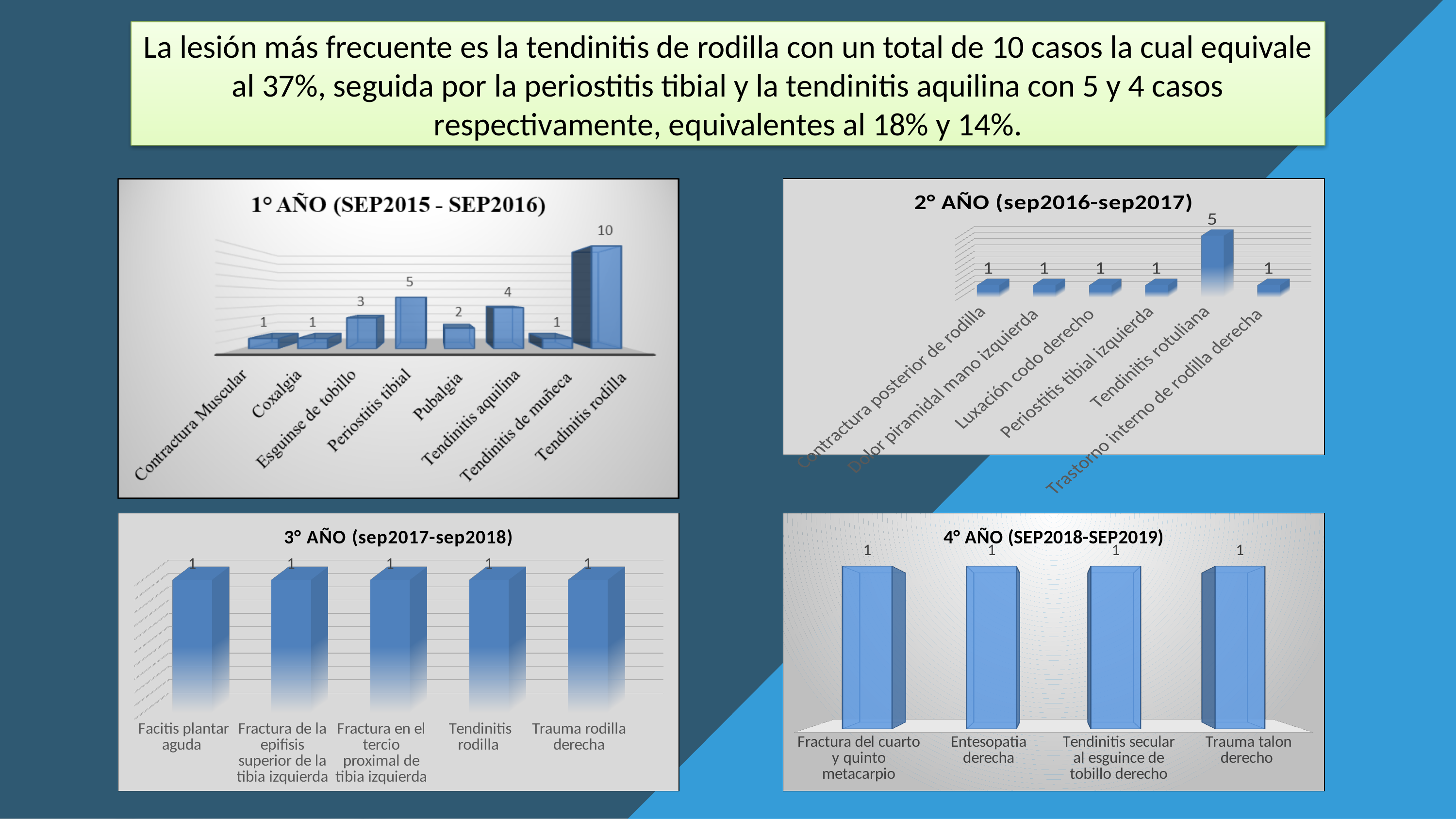
In the chart titled "1° AÑO (SEP2015 - SEP2016)", what is the value for Tendinitis rodilla? 10 In the chart titled "2° AÑO (sep2016-sep2017)", what is the value for Tendinitis rotuliana? 5 How many categories are shown in the chart titled "1° AÑO (SEP2015 - SEP2016)"? 8 In the chart titled "1° AÑO (SEP2015 - SEP2016)", what is the value for Periostitis tibial? 5 In the chart titled "4° AÑO (SEP2018-SEP2019)", what is the value for Trauma talon derecho? 1 In the chart titled "1° AÑO (SEP2015 - SEP2016)", which is larger, Esguinse de tobillo or Pubalgia? Esguinse de tobillo What kind of chart is the chart titled "4° AÑO (SEP2018-SEP2019)"? Bar chart How many categories are shown in the chart titled "3° AÑO (sep2017-sep2018)"? 5 In the chart titled "1° AÑO (SEP2015 - SEP2016)", what is the difference between Tendinitis rodilla and Tendinitis aquilina? 6 In the chart titled "2° AÑO (sep2016-sep2017)", which category has the highest value? Tendinitis rotuliana How many categories are shown in the chart titled "2° AÑO (sep2016-sep2017)"? 6 In the chart titled "1° AÑO (SEP2015 - SEP2016)", which category has the highest value? Tendinitis rodilla